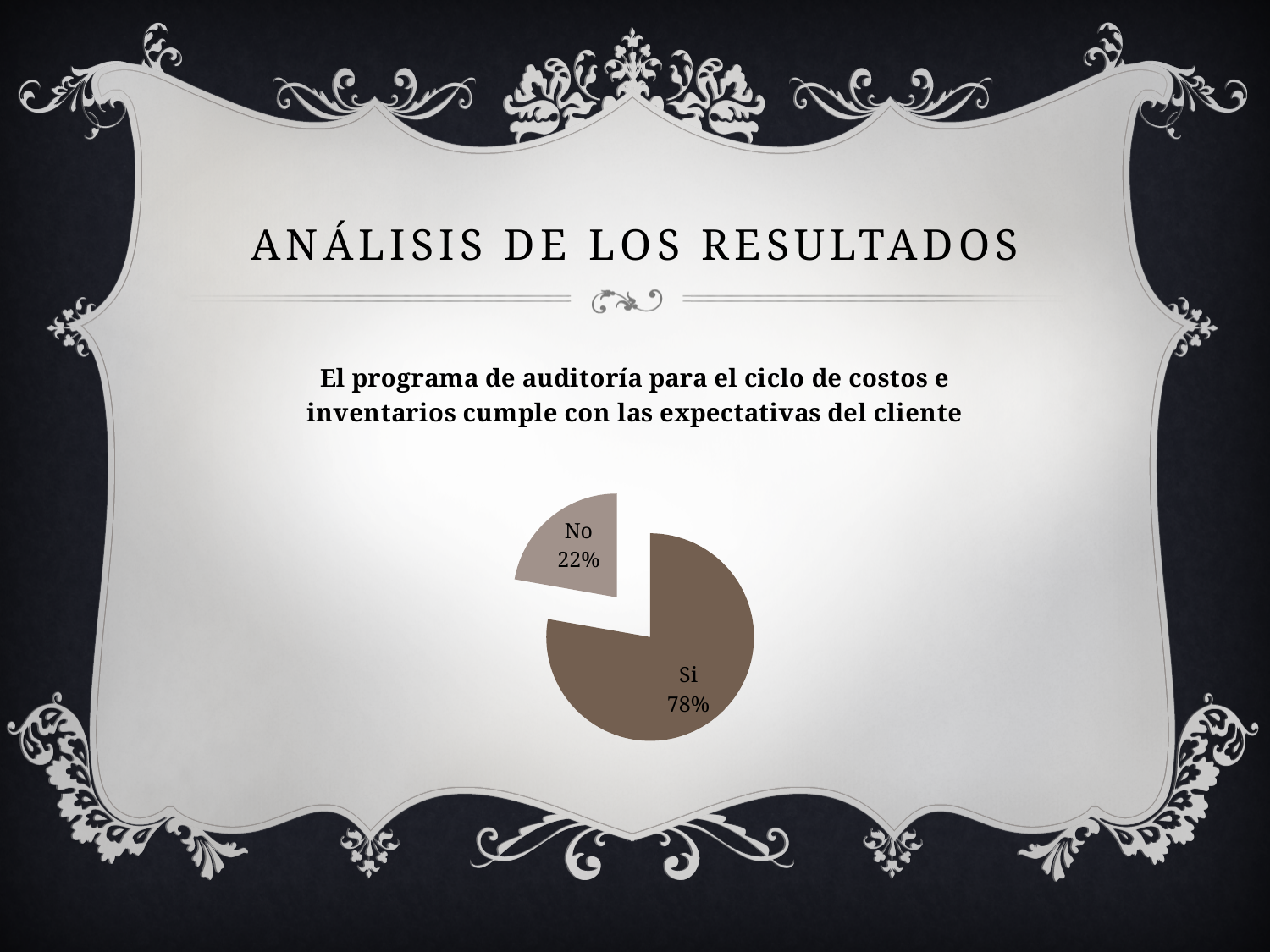
What percentage is shown for the "No" slice? 22% What is the difference in percentage points between the "Si" and "No" slices? 56 What kind of chart is shown on the slide? pie chart Which slice is separated (exploded) from the rest of the pie? No Which slice of the pie is the largest? Si How many slices does the pie chart have? 2 Which slice of the pie is the smallest? No Which is larger, the "Si" slice or the "No" slice? Si What share of the pie does the "No" slice represent? 22% What is the title of the slide containing the chart? Análisis de los resultados What percentage is shown for the "Si" slice? 78%